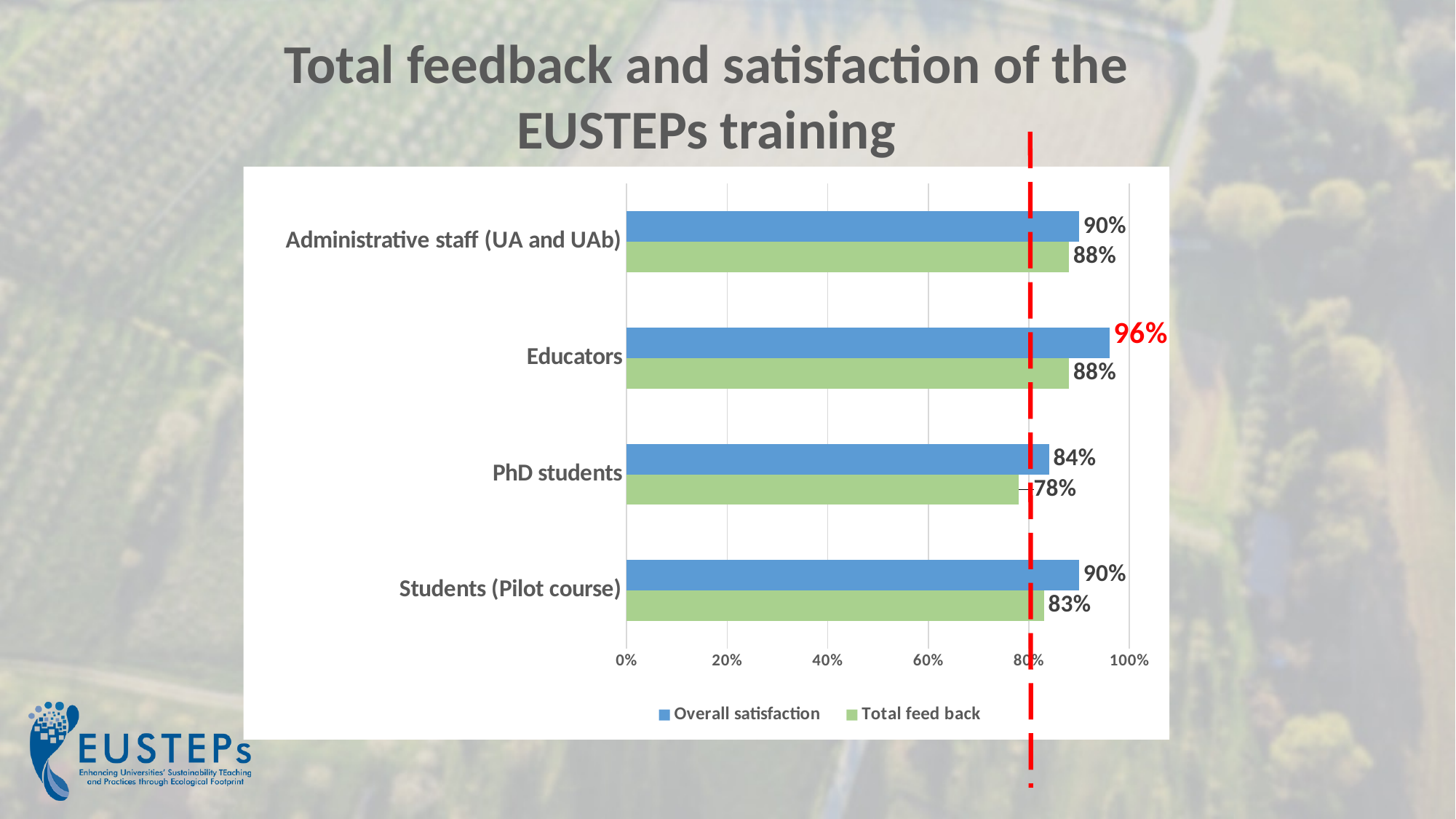
How many categories are shown on the chart? 4 Which category has the highest Overall satisfaction? Educators How many series does the legend list? 2 Is the Total feed back value for PhD students greater or less than 80%? less Which is larger for Students (Pilot course): Overall satisfaction or Total feed back? Overall satisfaction What is the Total feed back value for Administrative staff (UA and UAb)? 88% What is the Overall satisfaction value for Educators? 96% Which category has the lowest Total feed back? PhD students What is the Overall satisfaction value for Students (Pilot course)? 90% What is the Total feed back value for PhD students? 78% What is the difference between Overall satisfaction and Total feed back for PhD students? 6% What kind of chart is shown on the slide? Bar chart